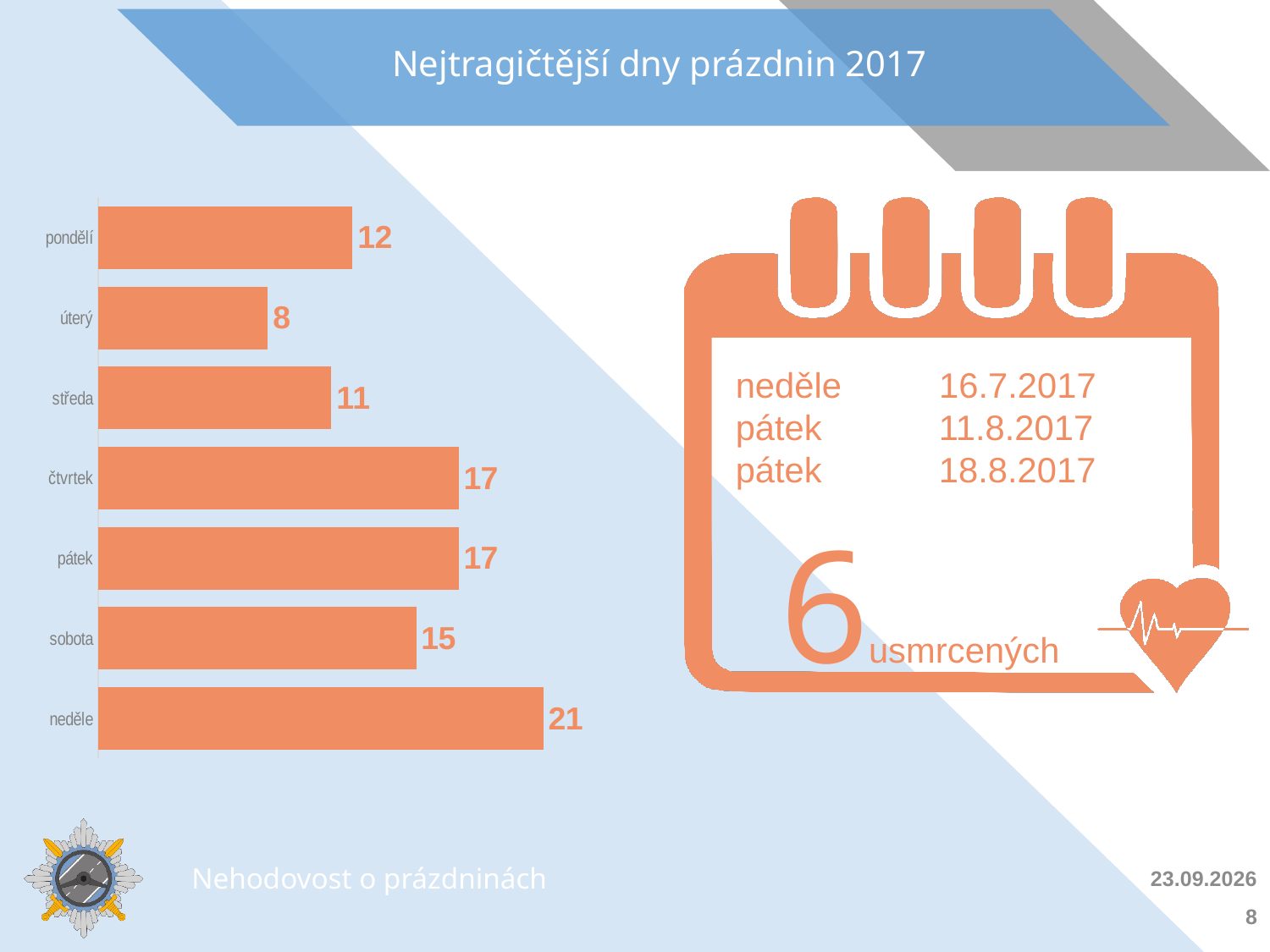
What is the value for úterý? 8 How many days are shown in the chart? 7 Which day has the lowest value? úterý What is the difference between the values for pondělí and středa? 1 What is the value for sobota? 15 What is the difference between the values for neděle and úterý? 13 What colour are the bars in the chart? orange What is the value for neděle? 21 Which day has the highest value? neděle What is the value for čtvrtek? 17 What kind of chart is shown on the slide? bar chart Which is larger, the value for sobota or the value for pátek? pátek